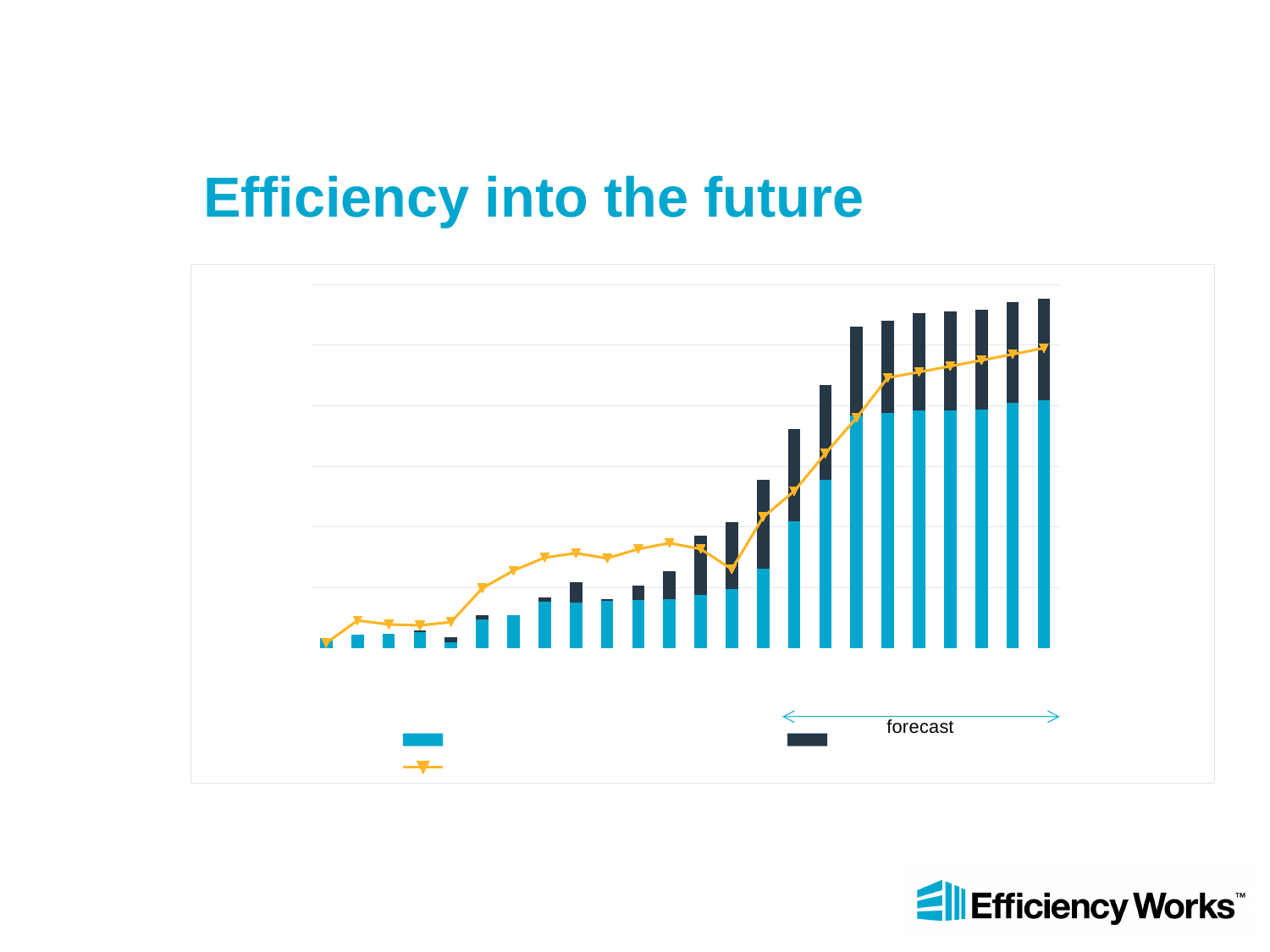
What word labels the arrow annotation below the right-hand part of the chart? forecast Where is the tallest bar located on the chart? At the far right Does the orange line generally rise or fall from left to right? Rise Which bar has the greatest total height, the leftmost or the rightmost? The rightmost Do the bar totals generally rise or fall from left to right along the x axis? Rise Where is the shortest bar located on the chart? At the far left What is the title of the slide containing the chart? Efficiency into the future What kind of chart is shown on the slide? A stacked bar chart with a line How many series does the chart's legend show? 3 What colour is the line series plotted on the chart? Orange